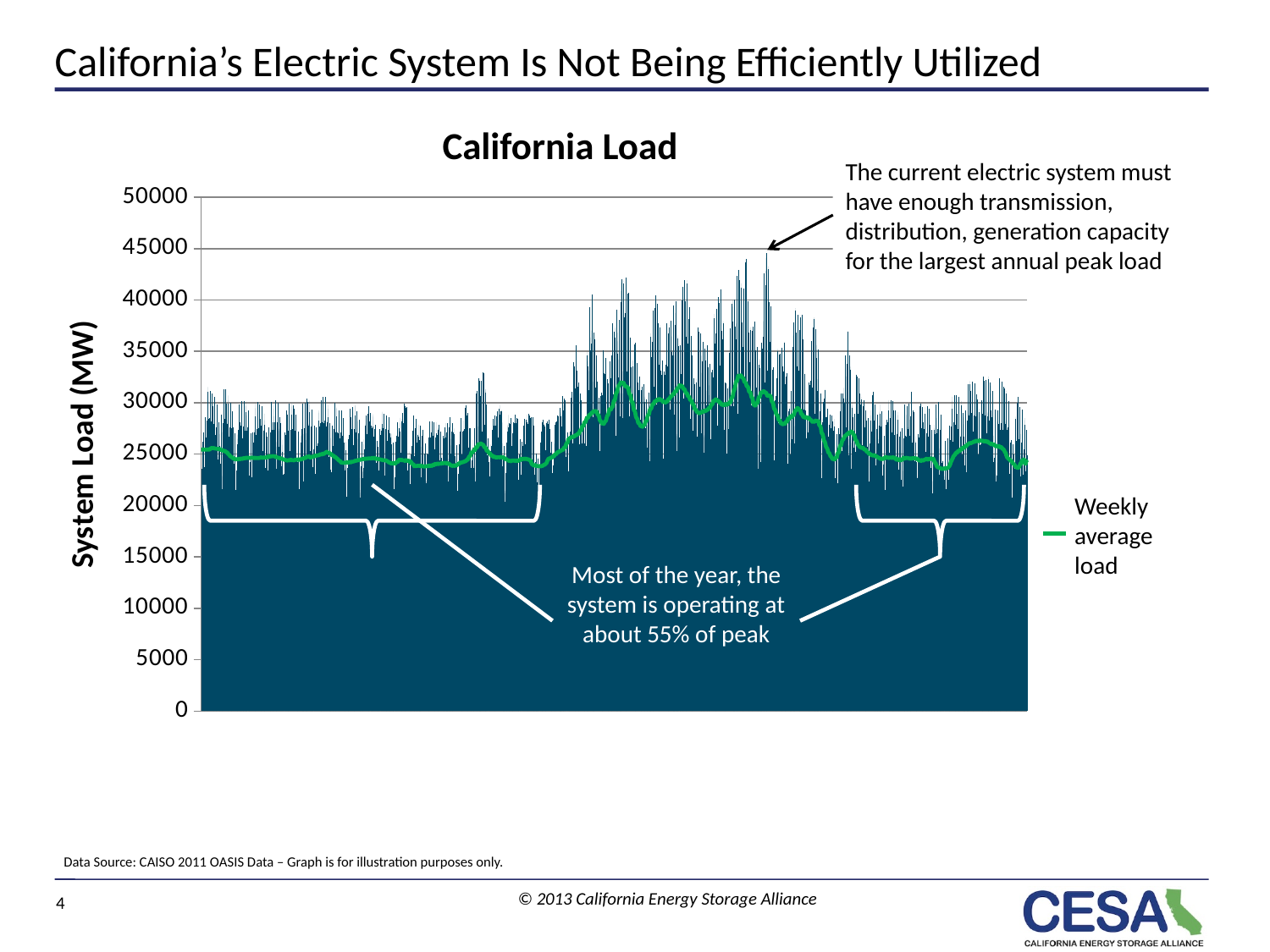
Is the highest peak of the system load greater or less than 40000? greater Does the weekly average load rise or fall from the middle of the chart toward the right end? fall What kind of chart is the "California Load" chart? area chart How many series does the legend of the "California Load" chart list? 1 What series is listed in the legend of the "California Load" chart? Weekly average load What is the title of the chart? California Load Is the weekly average load in the middle of the chart greater or less than 25000? greater Is the highest point of the weekly average load line greater or less than 35000? less Does the weekly average load rise or fall from the left end of the chart toward the middle? rise